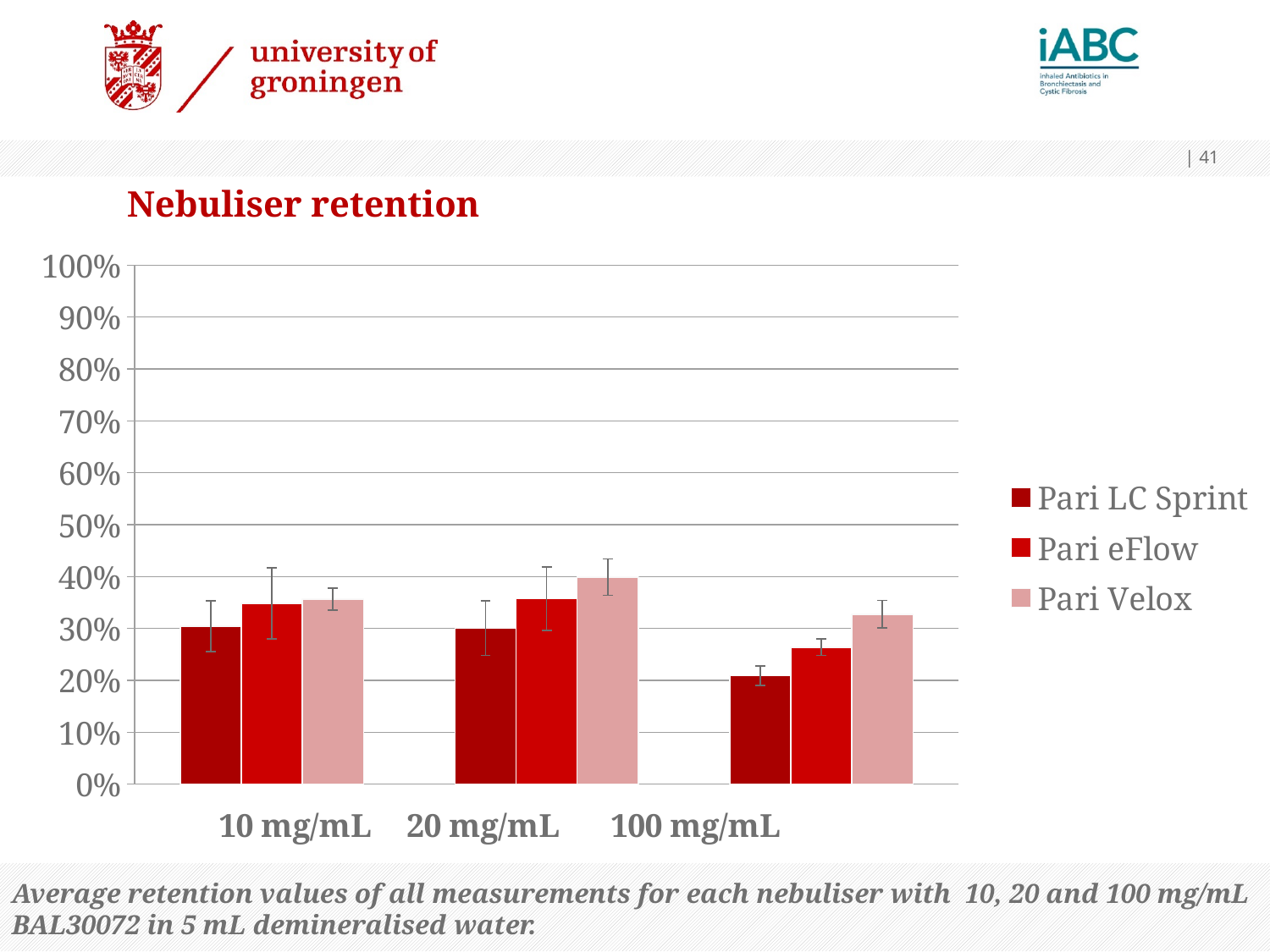
For Pari Velox, which concentration has the highest retention? 20 mg/mL Is the value for Pari LC Sprint at 100 mg/mL greater or less than 30%? less At 100 mg/mL, which is larger: Pari Velox or Pari LC Sprint? Pari Velox How many concentration categories are shown on the x axis? 3 Is the value for Pari Velox at 20 mg/mL greater or less than 30%? greater For Pari LC Sprint, which concentration has the lowest retention? 100 mg/mL Which nebulisers are listed in the legend? Pari LC Sprint, Pari eFlow, Pari Velox Is the value for Pari eFlow at 100 mg/mL greater or less than 30%? less What is the title of the chart? Nebuliser retention How many series does the legend list? 3 What kind of chart is shown on the slide? bar chart